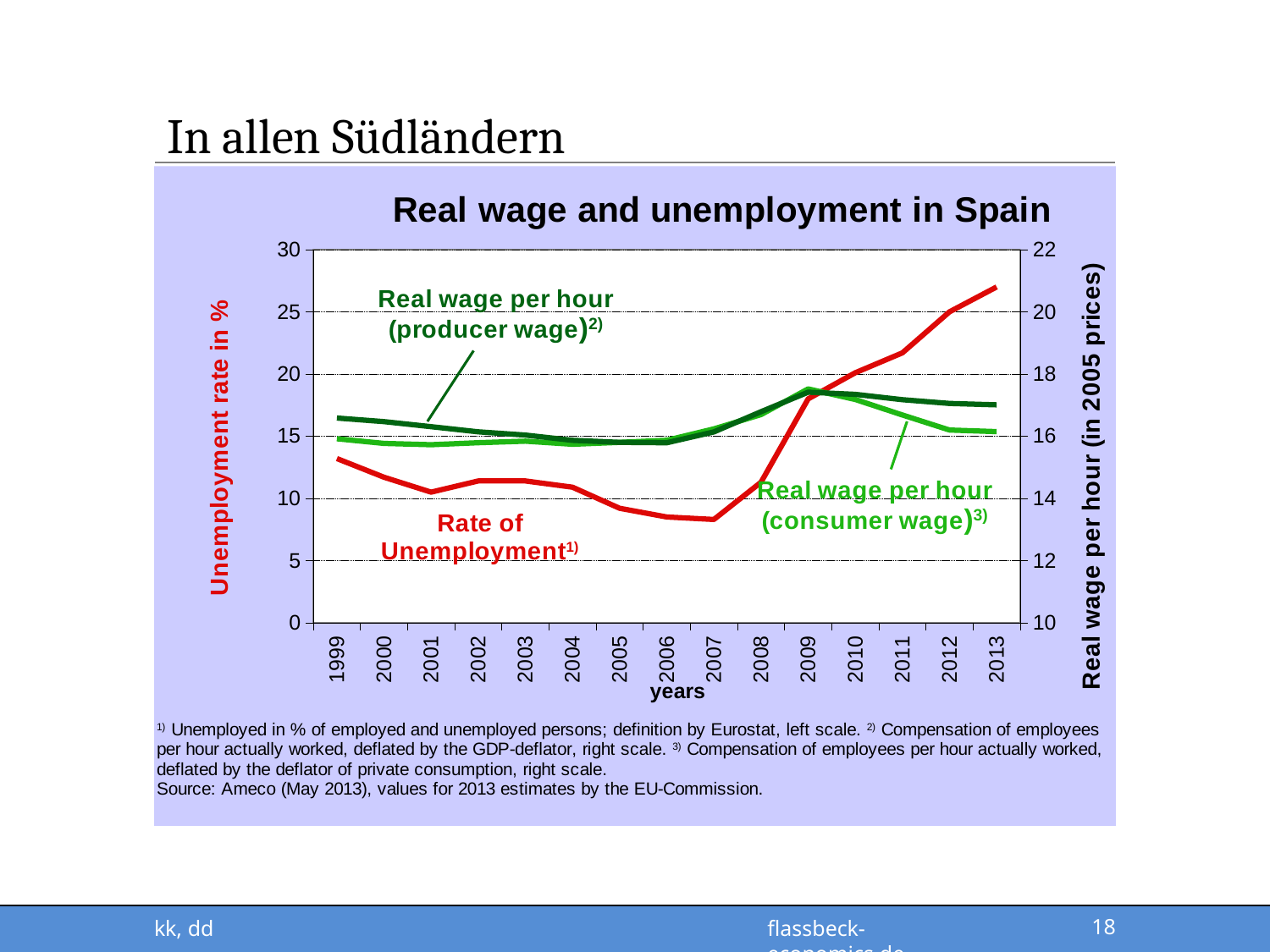
In which year is the Rate of Unemployment highest? 2013 What is the label of the left vertical axis? Unemployment rate in % What is the title of the chart? Real wage and unemployment in Spain What kind of chart is shown on the slide? line chart Does the Rate of Unemployment rise or fall from 2007 to 2013? rise How many years are shown on the x axis of the chart? 15 Is the Rate of Unemployment in 2007 greater or less than 10? less Which is larger, the Rate of Unemployment in 1999 or in 2013? 2013 Is the Rate of Unemployment in 2013 greater or less than 25? greater How many series are plotted in the chart? 3 In which year is the Rate of Unemployment lowest? 2007 Is the Real wage per hour (consumer wage) in 2013 greater or less than 18 on the right scale? less